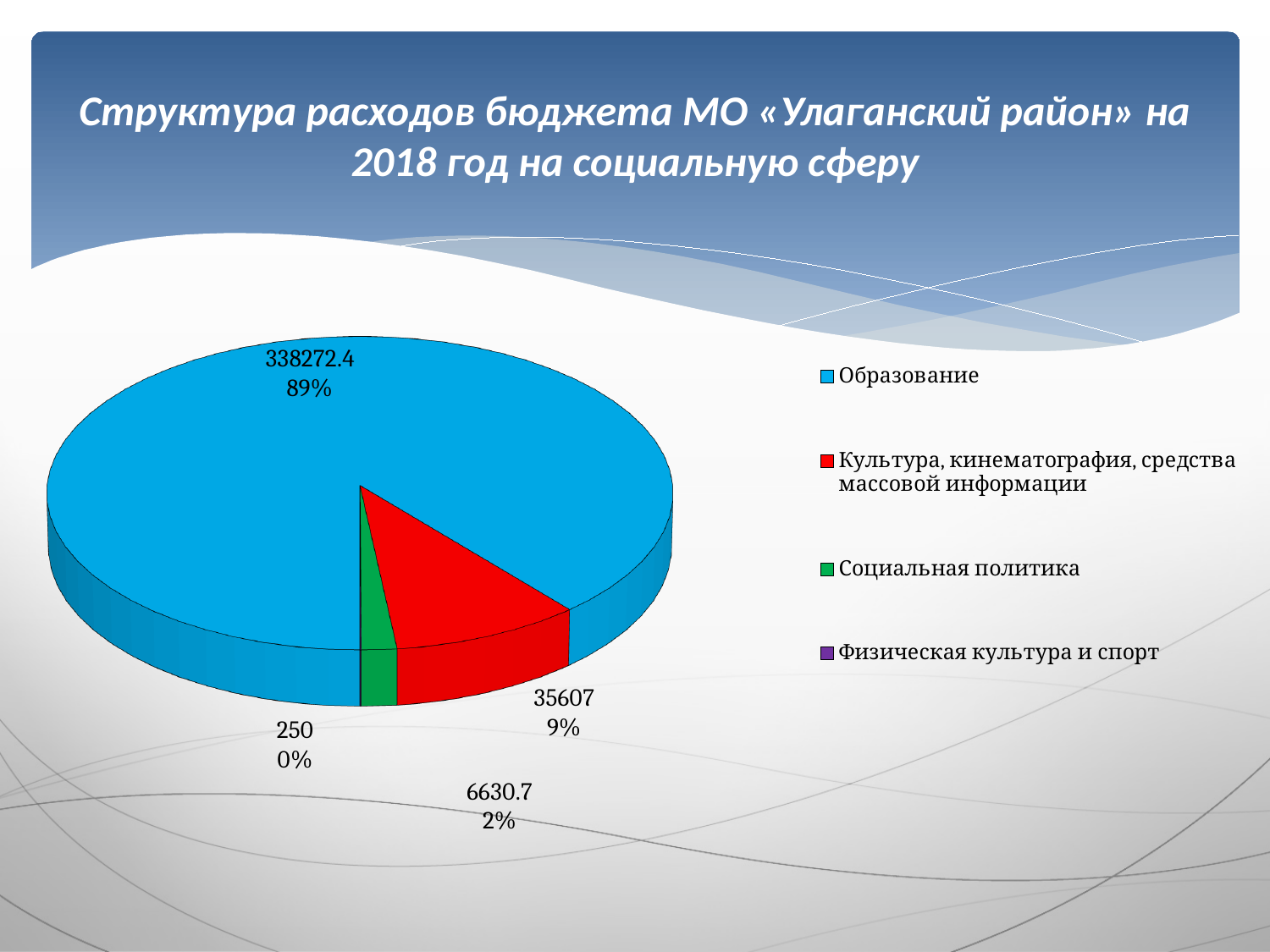
What is the value for Культура, кинематография, средства массовой информации? 35607 What share of the pie does Образование take? 89% Which is larger: Социальная политика or Культура, кинематография, средства массовой информации? Культура, кинематография, средства массовой информации What colour is the slice for Социальная политика? green Which category has the largest slice of the pie? Образование What is the value for Социальная политика? 6630.7 Which category has the smallest slice of the pie? Физическая культура и спорт What is the value for Физическая культура и спорт? 250 How many categories does the legend list? 4 What share of the pie does Культура, кинематография, средства массовой информации take? 9% What kind of chart is shown on the slide? pie chart What is the value for Образование? 338272.4